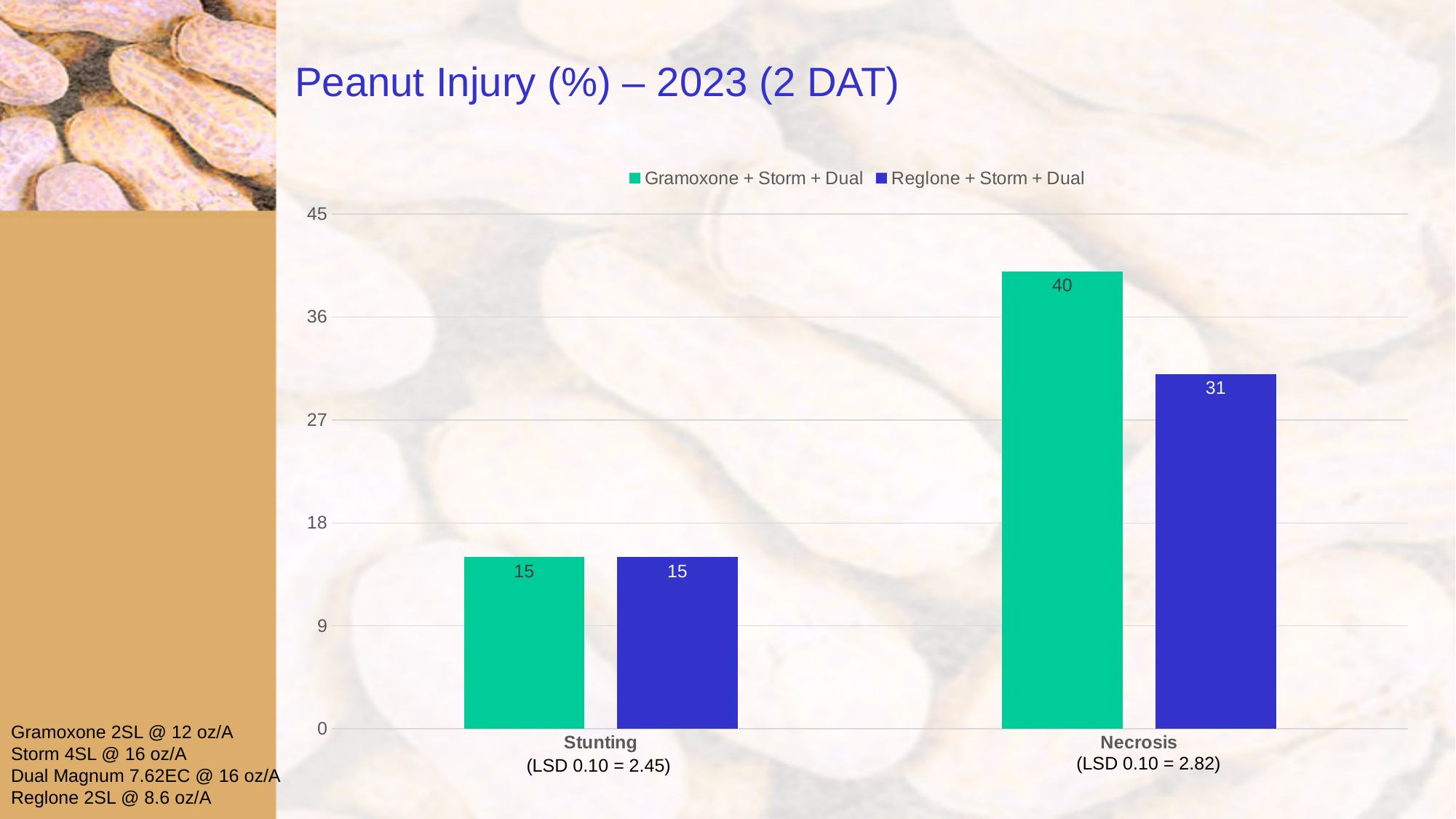
Which series has the highest Necrosis value? Gramoxone + Storm + Dual What is the Necrosis value for Reglone + Storm + Dual? 31 What is the Stunting value for Gramoxone + Storm + Dual? 15 What is the Necrosis value for Gramoxone + Storm + Dual? 40 Which is larger for Gramoxone + Storm + Dual: the Stunting value or the Necrosis value? Necrosis What kind of chart is shown on the slide? Bar chart How many series does the legend list? 2 What is the difference between the Necrosis values for Gramoxone + Storm + Dual and Reglone + Storm + Dual? 9 Is the Necrosis value for Reglone + Storm + Dual greater or less than 27? greater What is the title of the chart? Peanut Injury (%) – 2023 (2 DAT) What is the Stunting value for Reglone + Storm + Dual? 15 How many categories are shown on the x axis? 2